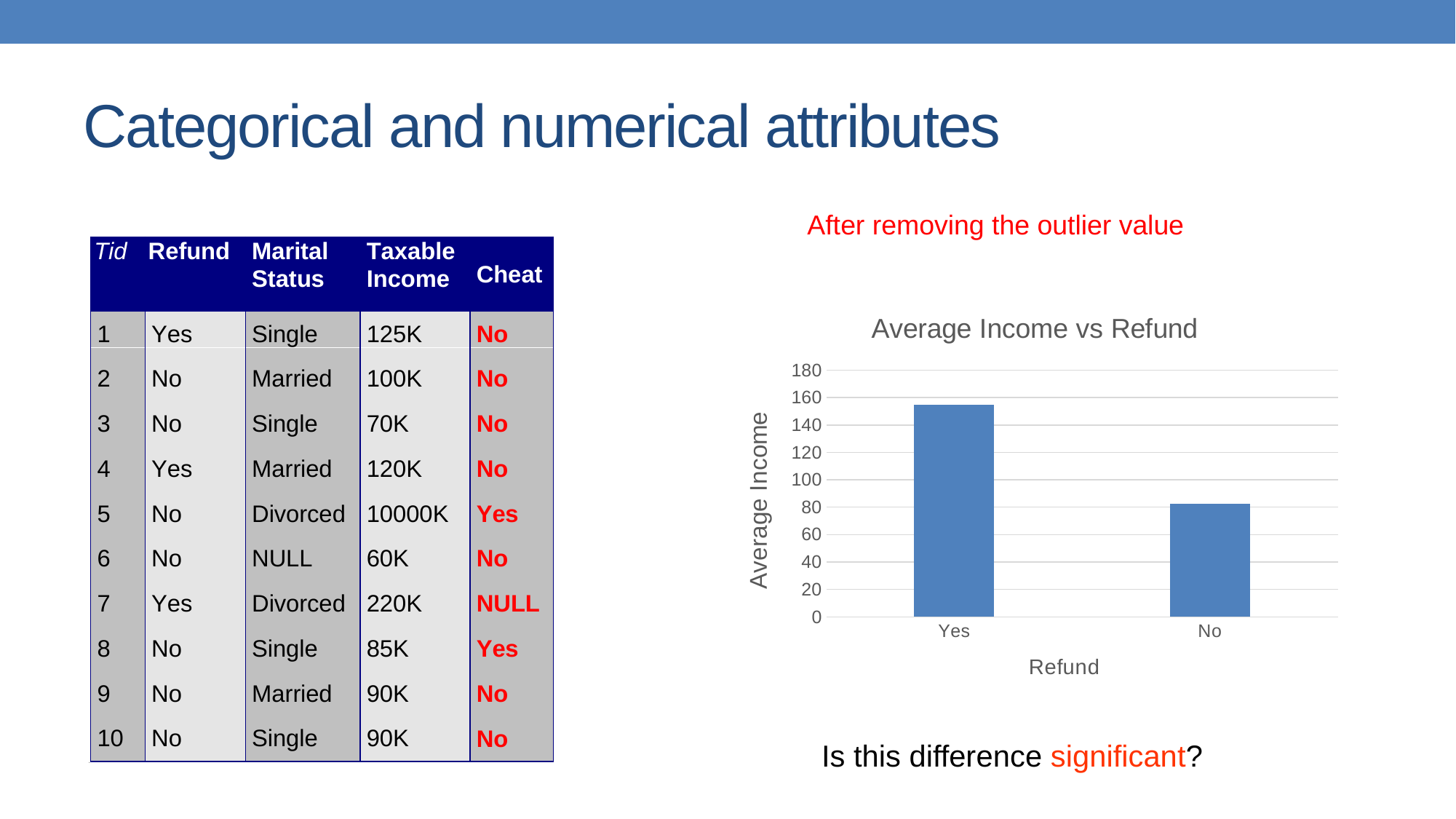
How many categories are plotted on the x axis of the chart? 2 Is the average income for Refund = No greater or less than 100? less What kind of chart is shown on the slide? bar chart What is the label of the y axis of the chart? Average Income Is the average income for Refund = Yes greater or less than 140? greater Is the average income for Refund = No greater or less than 60? greater Which Refund category has the highest average income in the chart? Yes What is the title of the chart? Average Income vs Refund Which has a larger average income in the chart, Refund = Yes or Refund = No? Yes Which Refund category has the lowest average income in the chart? No